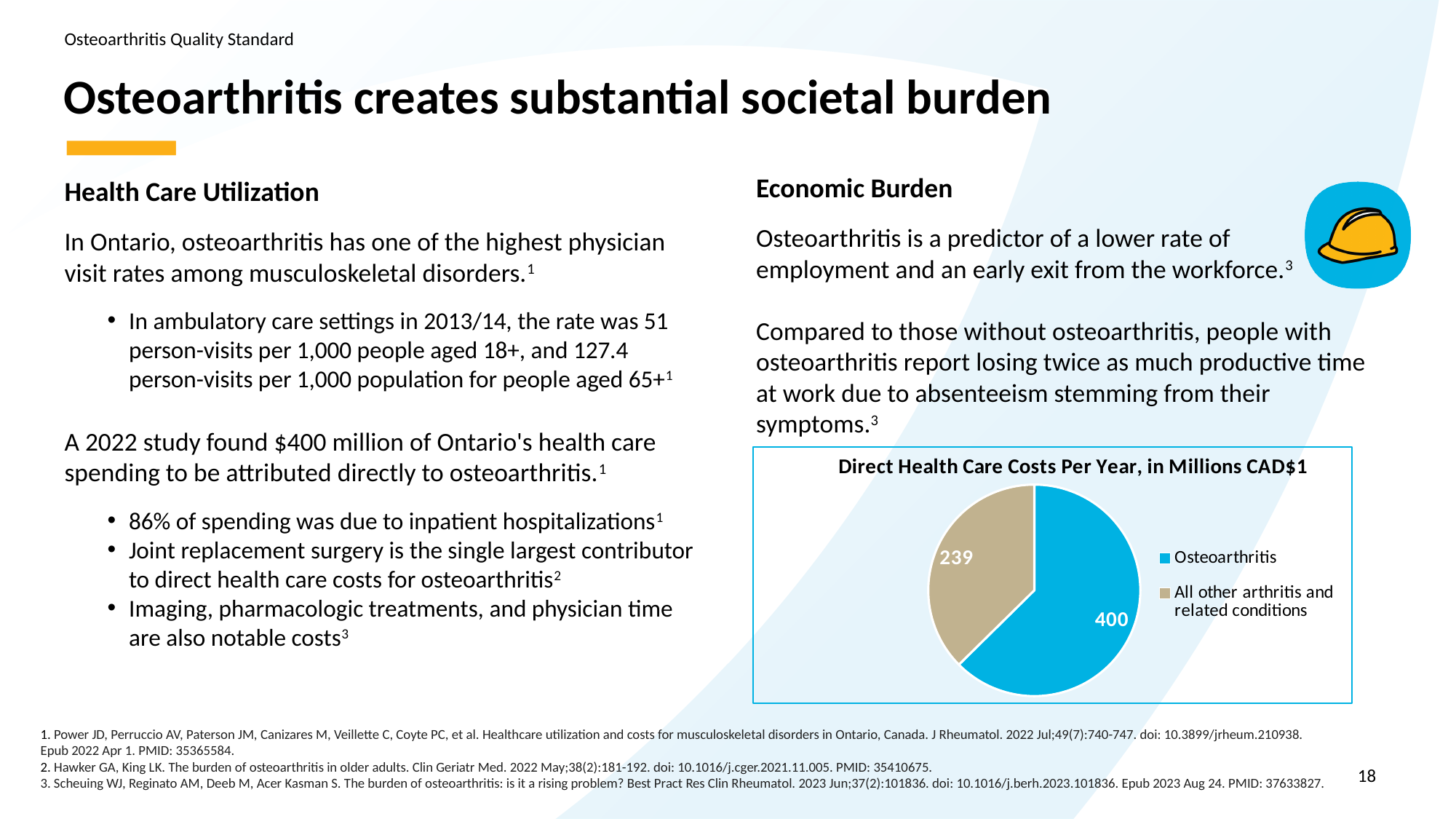
How many entries does the pie chart's legend list? 2 What is the value for All other arthritis and related conditions in the pie chart? 239 What kind of chart is shown on the slide? Pie chart What is the total of the two values shown in the pie chart? 639 Which is larger in the pie chart: Osteoarthritis or All other arthritis and related conditions? Osteoarthritis What is the value for Osteoarthritis in the pie chart? 400 Which slice of the pie chart is the smallest? All other arthritis and related conditions How many slices does the pie chart have? 2 What is the title of the pie chart? Direct Health Care Costs Per Year, in Millions CAD$1 What colour is the Osteoarthritis slice in the pie chart? Blue Which slice of the pie chart is the largest? Osteoarthritis What is the difference between the Osteoarthritis value and the All other arthritis and related conditions value in the pie chart? 161